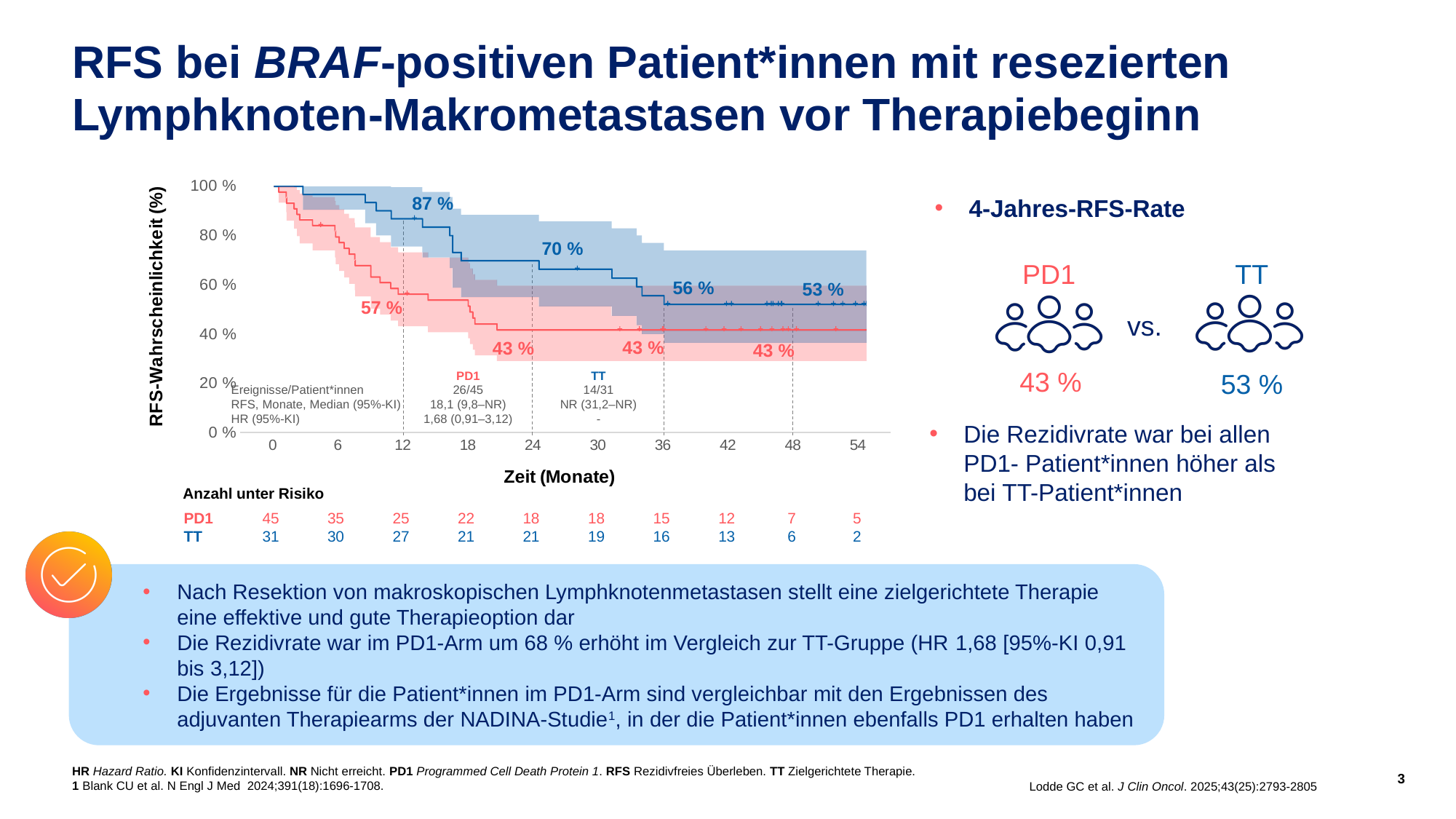
What is the RFS rate for the PD1 group at 12 months? 57 % Do the RFS curves rise or fall along the x axis (time in months)? fall What is the label of the x axis of the chart? Zeit (Monate) What is the RFS rate for the PD1 group at 24 months? 43 % How many patients in the PD1 group were at risk at 0 months? 45 How many groups (series) are plotted in the chart? 2 What is the difference between the TT and PD1 RFS rates at 12 months? 30 % What is the RFS rate for the TT group at 12 months? 87 % How many patients in the TT group were at risk at 24 months? 21 Which group has the higher RFS rate at 24 months, PD1 or TT? TT What is the difference between the TT and PD1 RFS rates at 36 months? 13 % What is the RFS rate for the TT group at 48 months? 53 %